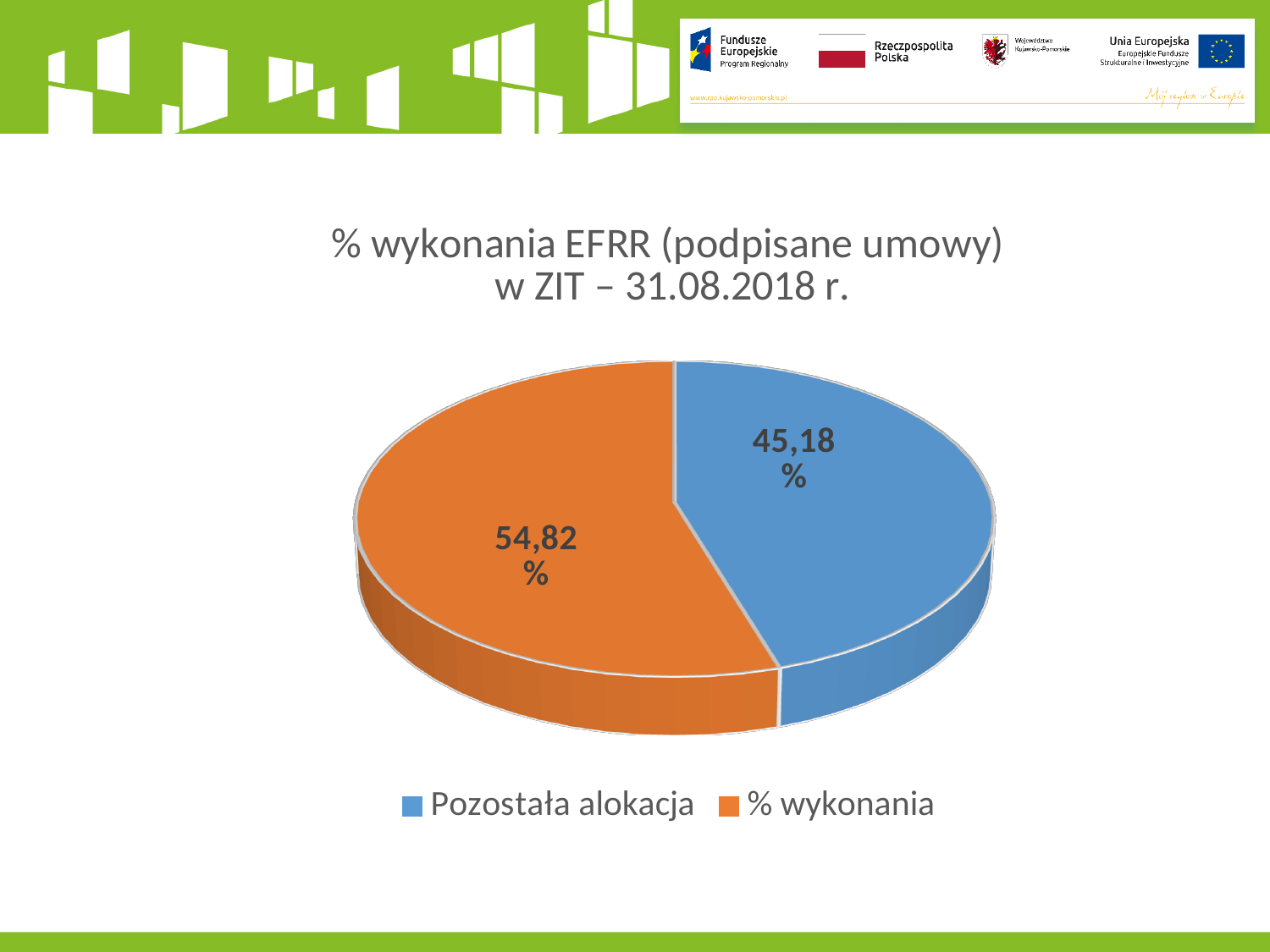
Which is larger, "Pozostała alokacja" or "% wykonania"? % wykonania Which slice is the largest? % wykonania What colour is the "% wykonania" slice? orange What is the title of the chart? % wykonania EFRR (podpisane umowy) w ZIT – 31.08.2018 r. What is the value shown for "% wykonania"? 54,82% What is the difference between the "% wykonania" slice and the "Pozostała alokacja" slice? 9,64% What is the value shown for "Pozostała alokacja"? 45,18% How many entries does the legend list? 2 Which slice is the smallest? Pozostała alokacja What kind of chart is shown on the slide? pie chart Is the value for "Pozostała alokacja" greater or less than 50%? less How many slices does the pie chart have? 2